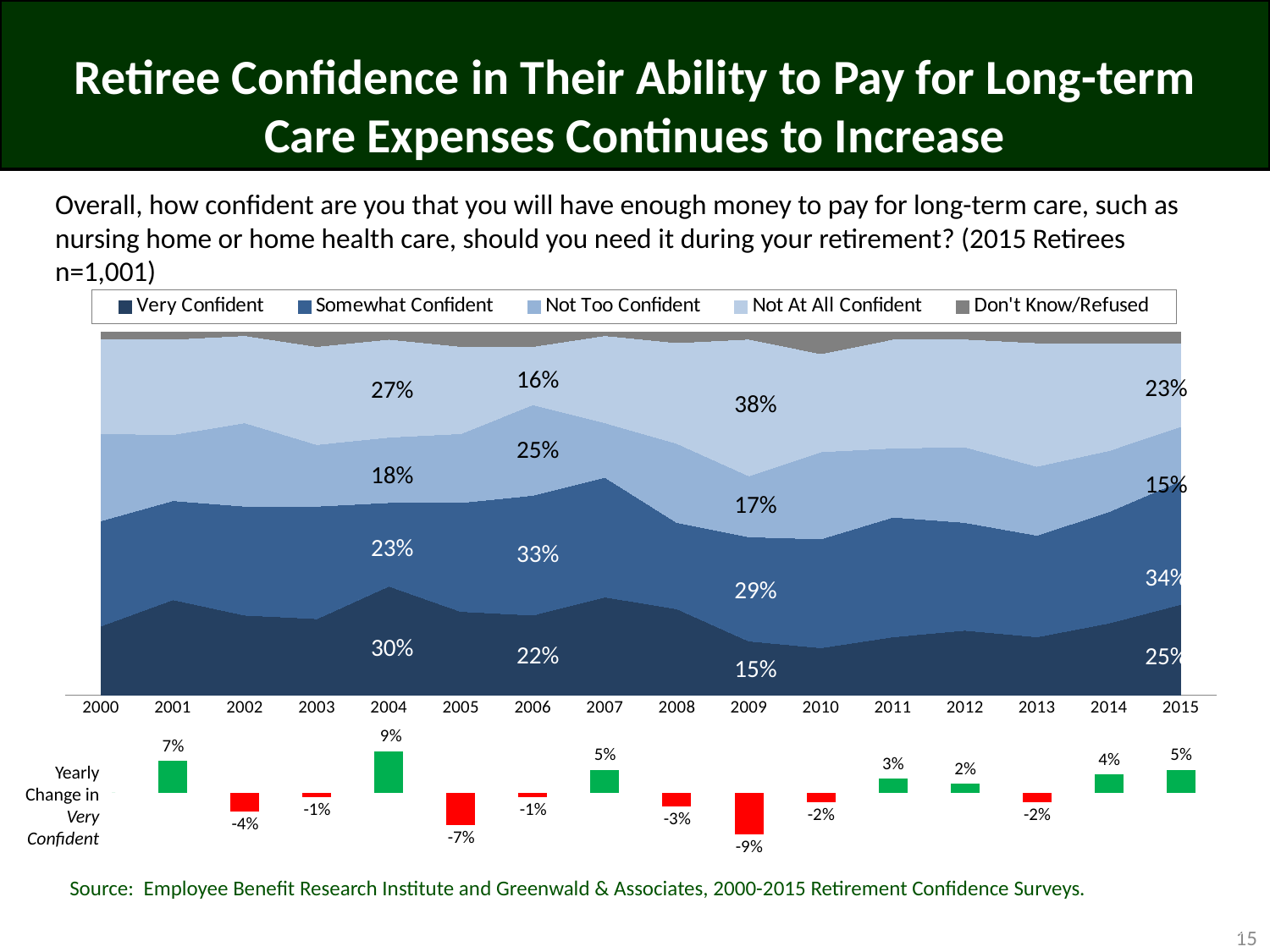
In the bottom chart of yearly change in Very Confident, what is the value for 2005? -7% In the top stacked area chart, which was larger in 2015: the Somewhat Confident share or the Not At All Confident share? Somewhat Confident In the bottom chart of yearly change in Very Confident, which year shows the largest decrease? 2009 In the top stacked area chart, what is the difference between the Very Confident share in 2004 and in 2009? 15% In the top stacked area chart, what percentage of retirees were Not At All Confident in 2009? 38% In the bottom chart of yearly change in Very Confident, which year shows the largest increase? 2004 In the top stacked area chart, how many series does the legend list? 5 In the top stacked area chart, what percentage of retirees were Very Confident in 2015? 25% In the bottom chart of yearly change in Very Confident, how many years are shown? 15 What kind of chart is the bottom chart showing yearly change in Very Confident? Bar chart In the top stacked area chart, what percentage of retirees were Somewhat Confident in 2006? 33% In the top stacked area chart, what percentage of retirees were Not Too Confident in 2004? 18%